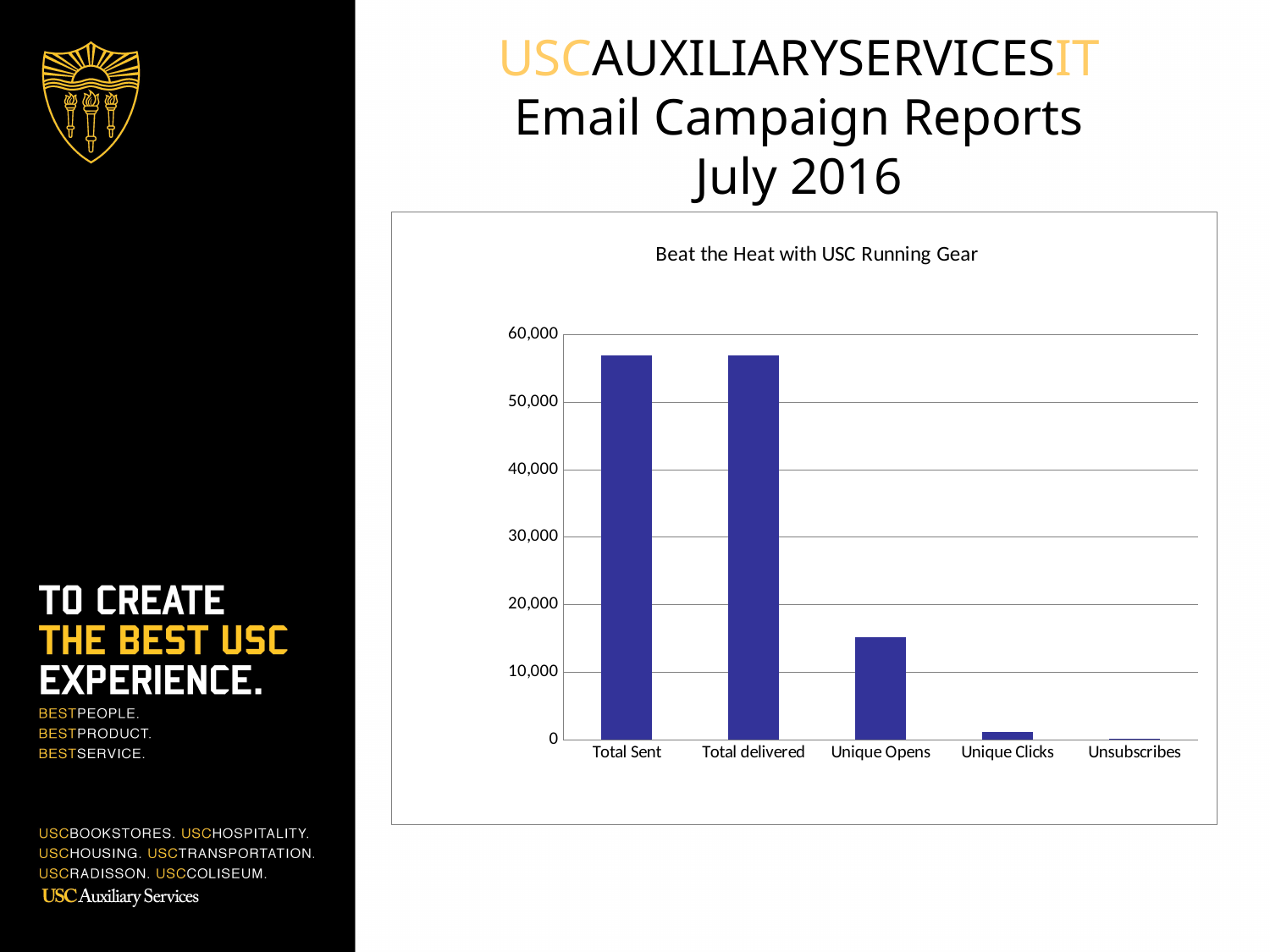
Do the values generally rise or fall moving from left to right along the x axis? fall What is the title of the chart? Beat the Heat with USC Running Gear Is the value for Total delivered greater or less than 60,000? less What kind of chart is shown on the slide? bar chart Which is larger, the value for Unique Clicks or the value for Unique Opens? Unique Opens Is the value for Unique Clicks greater or less than 10,000? less Which category has the lowest value in the chart? Unsubscribes Is the value for Unique Opens greater or less than 20,000? less Which is larger, the value for Total Sent or the value for Unique Opens? Total Sent How many categories are shown on the x axis of the chart? 5